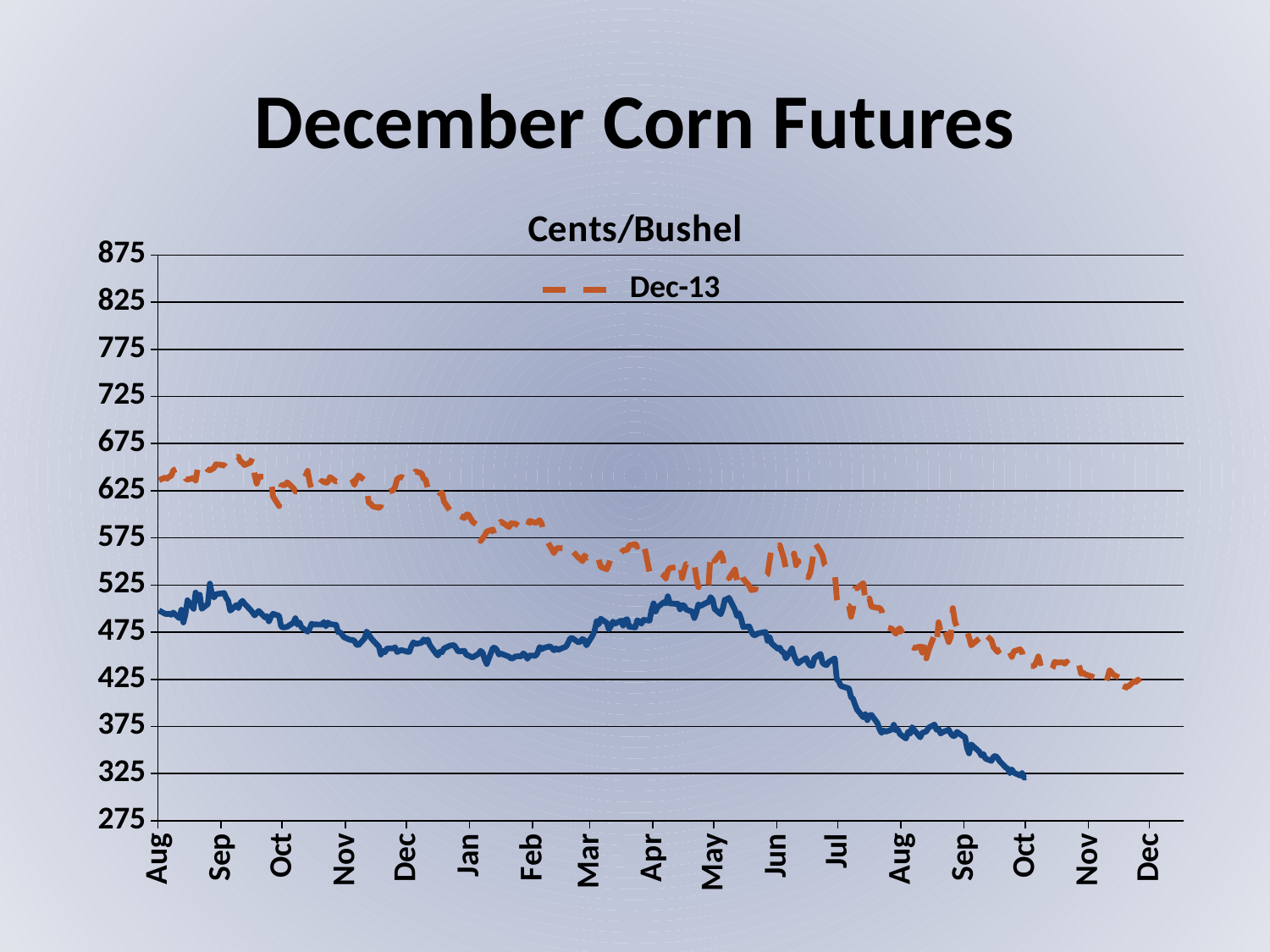
Is the value of the Dec-13 series at the end of the chart (Dec) greater or less than 475? less Is the value of the Dec-13 series at the start of the chart (Aug) greater or less than 600? greater Does the Dec-13 series overall rise or fall from the left of the x axis to the right? fall Is the highest value reached by the Dec-13 series greater or less than 675? less What kind of chart is shown on the slide? line chart Which line is higher throughout the chart, the dashed Dec-13 line or the solid blue line? Dec-13 What unit is shown above the chart's plot area? Cents/Bushel What is the highest value shown on the chart's vertical axis? 875 How many series does the chart's legend list? 1 What is the title of the chart on the slide? December Corn Futures